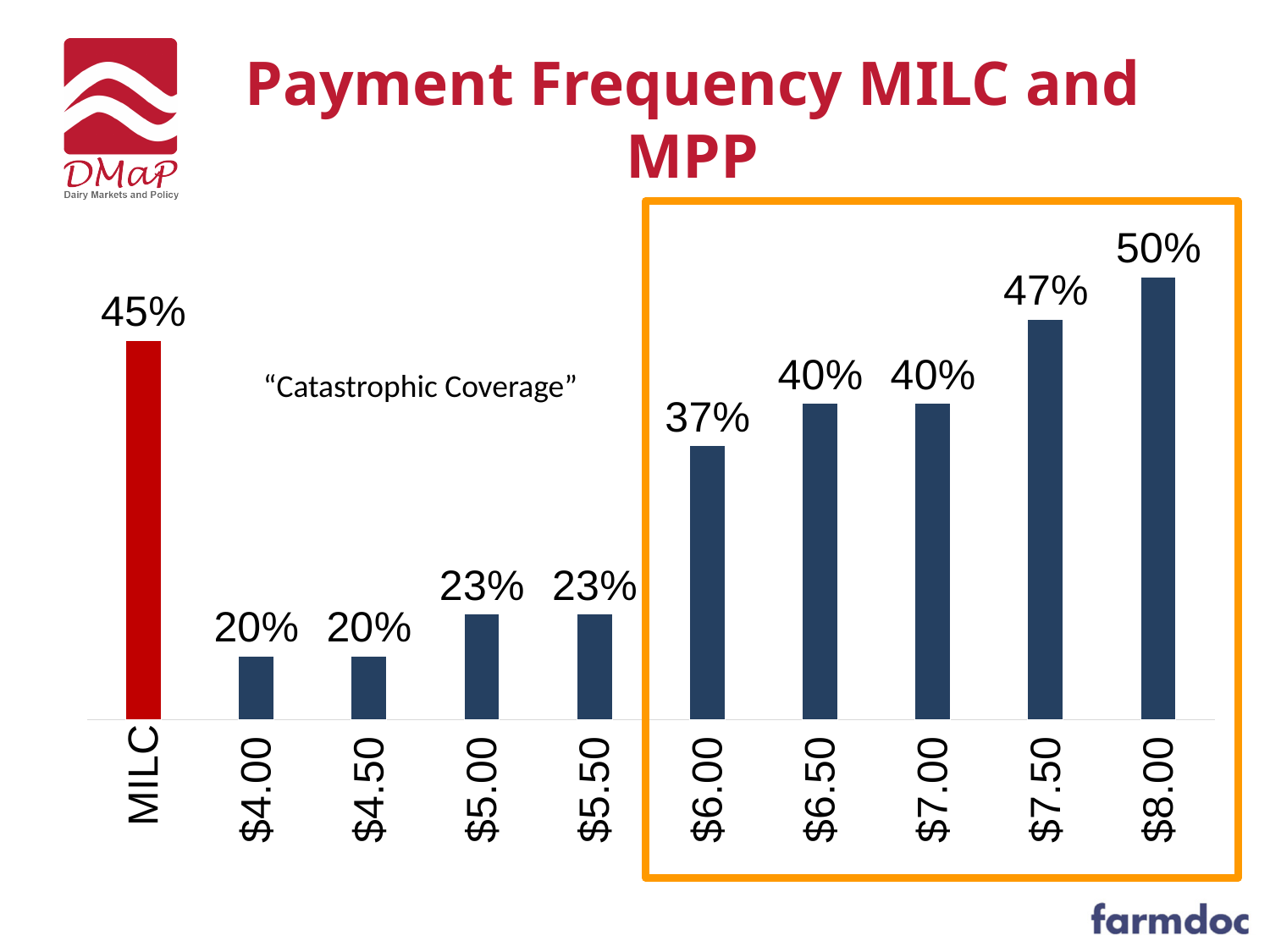
What is the value for MILC? 45% What is the value for $7.50? 47% What is the value for $6.00? 37% What is the difference between the values for $8.00 and MILC? 5% How many categories are shown on the x axis? 10 What kind of chart is shown on the slide? Bar chart Which category has the highest value? $8.00 Do the values rise or fall from $4.00 to $8.00 along the x axis? Rise What is the value for $4.50? 20% What is the difference between the values for $5.00 and $4.00? 3% What is the title of the chart? Payment Frequency MILC and MPP Which is larger, the value for MILC or the value for $7.00? MILC